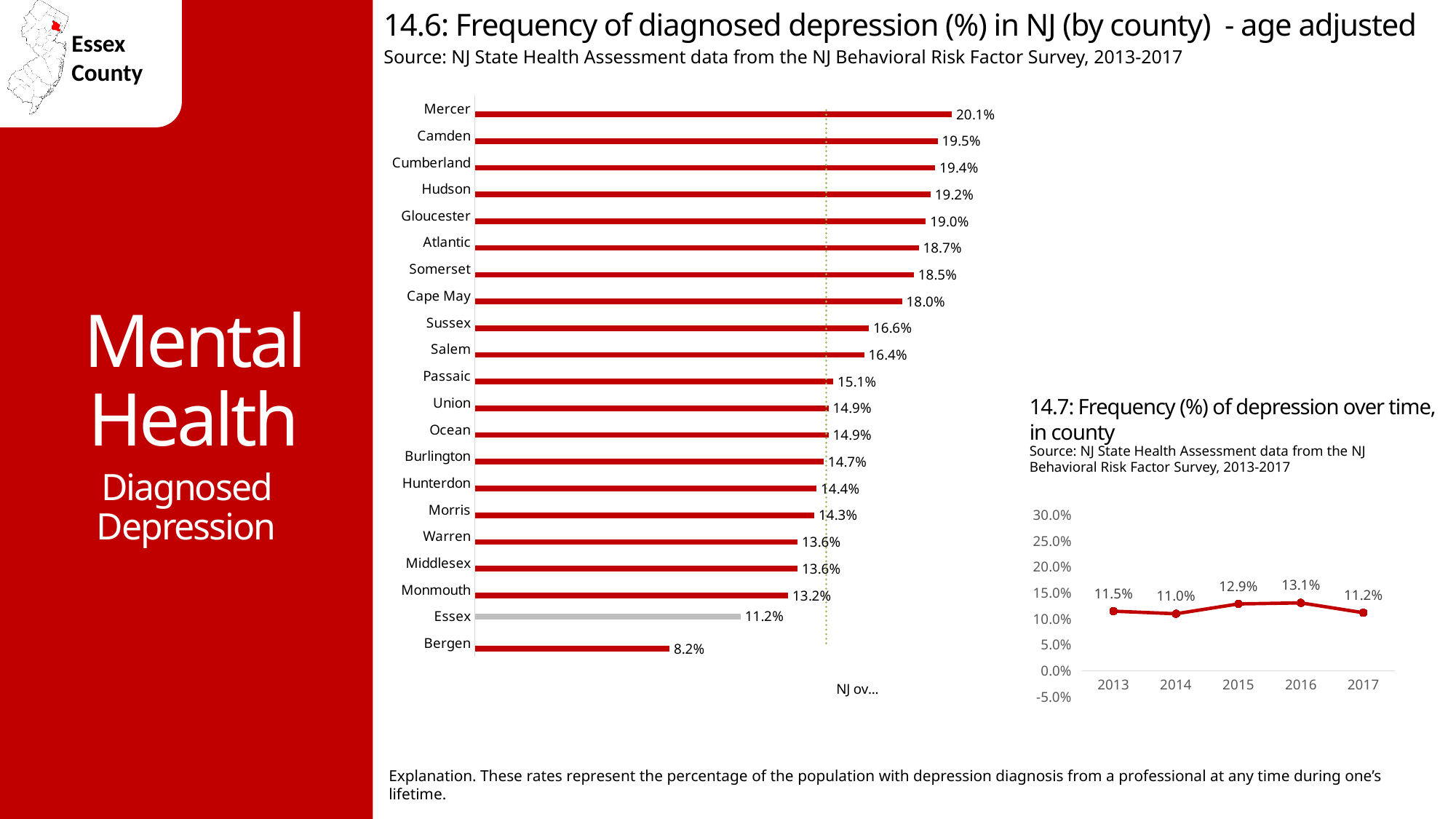
How many counties are shown in chart 14.6? 21 In chart 14.6, which bar is coloured grey instead of red? Essex In chart 14.6, what is the frequency of diagnosed depression for Mercer county? 20.1% In chart 14.6, which county has a higher value, Hudson or Cape May? Hudson In chart 14.7, which year has the lowest frequency of depression? 2014 In chart 14.6, what is the value shown for Essex county? 11.2% In chart 14.7, what is the difference between the 2015 and 2014 values? 1.9% In chart 14.6, which county has the highest frequency of diagnosed depression? Mercer In chart 14.6, what is the difference between the values for Mercer and Bergen? 11.9% In chart 14.6, which county has the lowest frequency of diagnosed depression? Bergen What type of chart is chart 14.6? Bar chart In chart 14.7, what is the frequency of depression in 2016? 13.1%